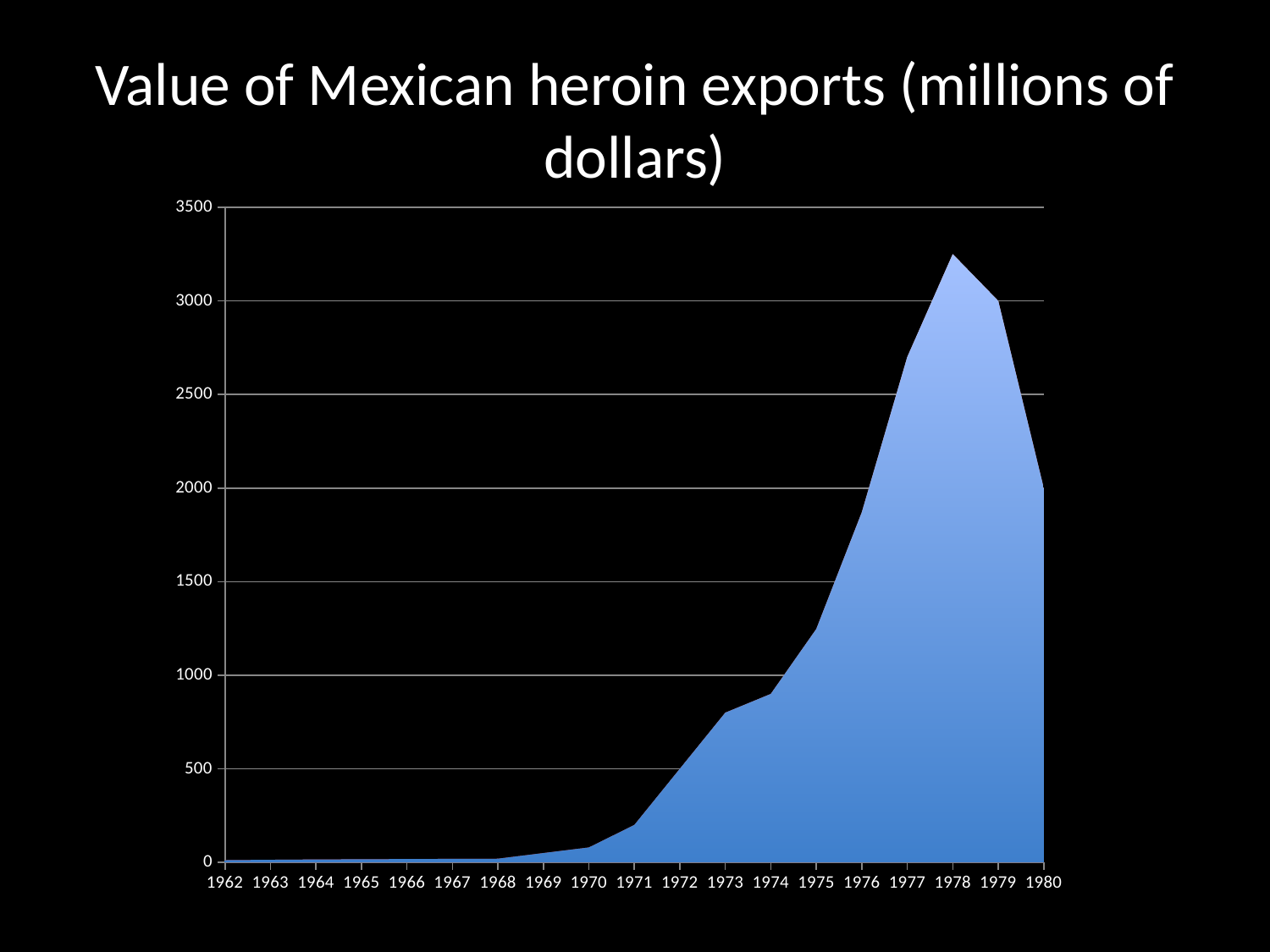
Is the value for 1971 greater or less than 500? less Which year has the highest value of Mexican heroin exports? 1978 Do the values generally rise or fall from 1962 to 1978? rise Is the value for 1977 greater or less than 2500? greater Which year has the larger value, 1978 or 1980? 1978 Is the value for 1974 greater or less than 1000? less How many years are shown on the x axis? 19 What kind of chart is shown on the slide? area chart What is the title of the chart? Value of Mexican heroin exports (millions of dollars)